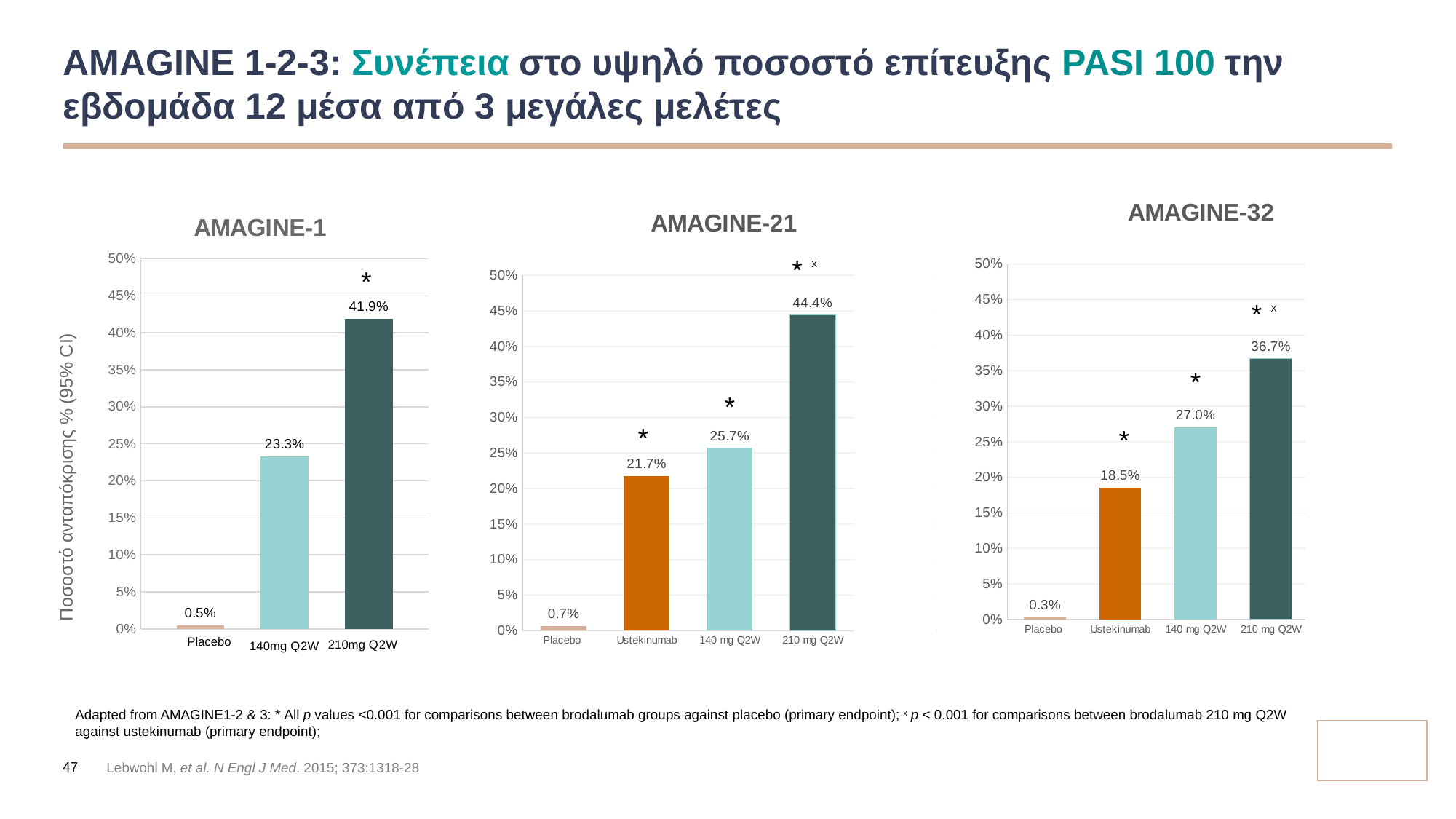
How many categories are shown in the left chart (AMAGINE-1)? 3 In the left chart (AMAGINE-1), what is the value for 210mg Q2W? 41.9% In the right chart, which category has the lowest value? Placebo How many categories are shown in the middle chart? 4 In the left chart (AMAGINE-1), what is the value for Placebo? 0.5% What type of chart is the right chart? Bar chart In the right chart, which is larger: the value for Ustekinumab or the value for 140 mg Q2W? 140 mg Q2W In the left chart (AMAGINE-1), what is the difference between the 210mg Q2W and 140mg Q2W values? 18.6% In the right chart, what is the value for 140 mg Q2W? 27.0% In the middle chart, what is the value for Ustekinumab? 21.7% In the middle chart, which category has the highest value? 210 mg Q2W In the middle chart, what is the difference between the 210 mg Q2W and Ustekinumab values? 22.7%